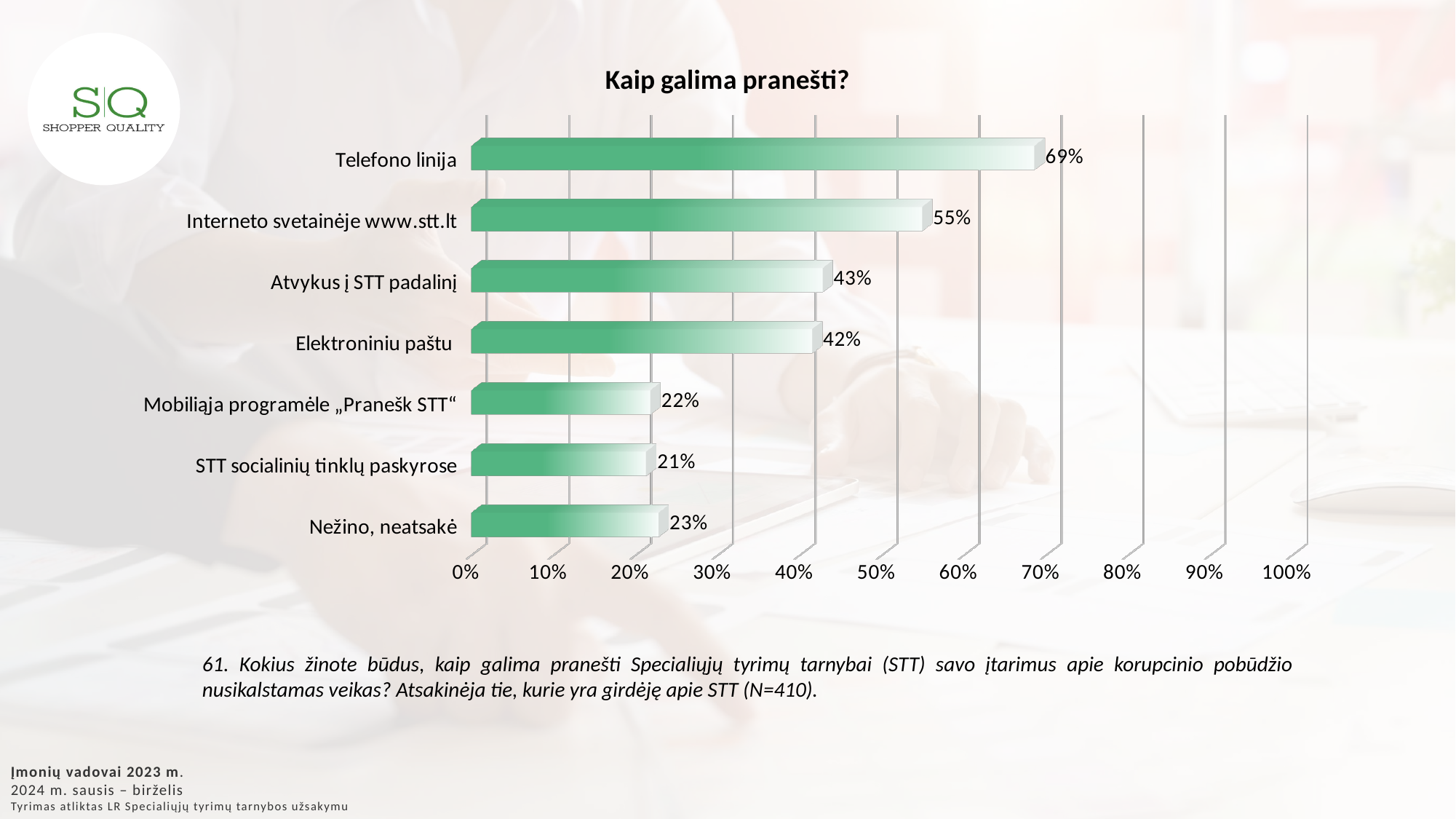
What is the value for Interneto svetainėje www.stt.lt? 55% How many categories are shown in the chart? 7 What is the difference between the values for Telefono linija and Interneto svetainėje www.stt.lt? 14% Is the value for Interneto svetainėje www.stt.lt greater or less than 50%? greater Which is larger: the value for Atvykus į STT padalinį or the value for Mobiliąja programėle „Pranešk STT“? Atvykus į STT padalinį Which category has the highest value? Telefono linija What is the title of the chart? Kaip galima pranešti? What is the value for Telefono linija? 69% What kind of chart is shown on the slide? bar chart Which category has the lowest value? STT socialinių tinklų paskyrose What is the value for Nežino, neatsakė? 23% What is the value for Elektroniniu paštu? 42%